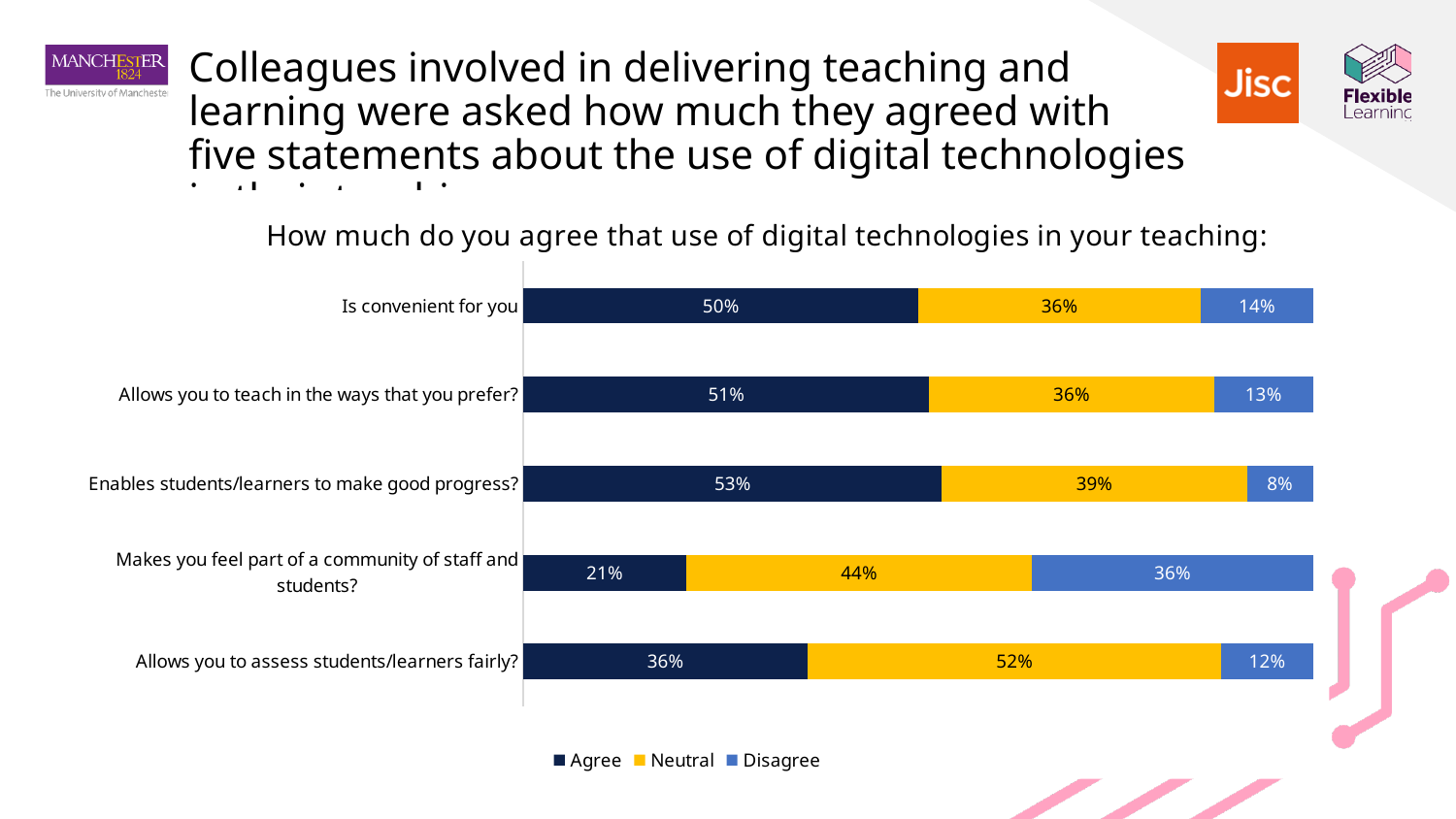
What type of chart is shown on the slide? Stacked bar chart What is the difference between the Agree and Disagree percentages for "Allows you to assess students/learners fairly?" 24% What is the Neutral value for "Allows you to assess students/learners fairly?" 52% What percentage of respondents agree that use of digital technologies in their teaching is convenient for them? 50% Which statement has the lowest Agree percentage? Makes you feel part of a community of staff and students? How many series does the legend list? 3 What are the three legend entries of the chart? Agree, Neutral, Disagree Which statement has the lowest Disagree percentage? Enables students/learners to make good progress? What is the Disagree value for "Makes you feel part of a community of staff and students?" 36% Which statement has the highest Agree percentage? Enables students/learners to make good progress? Is the Agree percentage higher for "Is convenient for you" or for "Allows you to teach in the ways that you prefer?" Allows you to teach in the ways that you prefer? How many statements are shown in the chart? 5